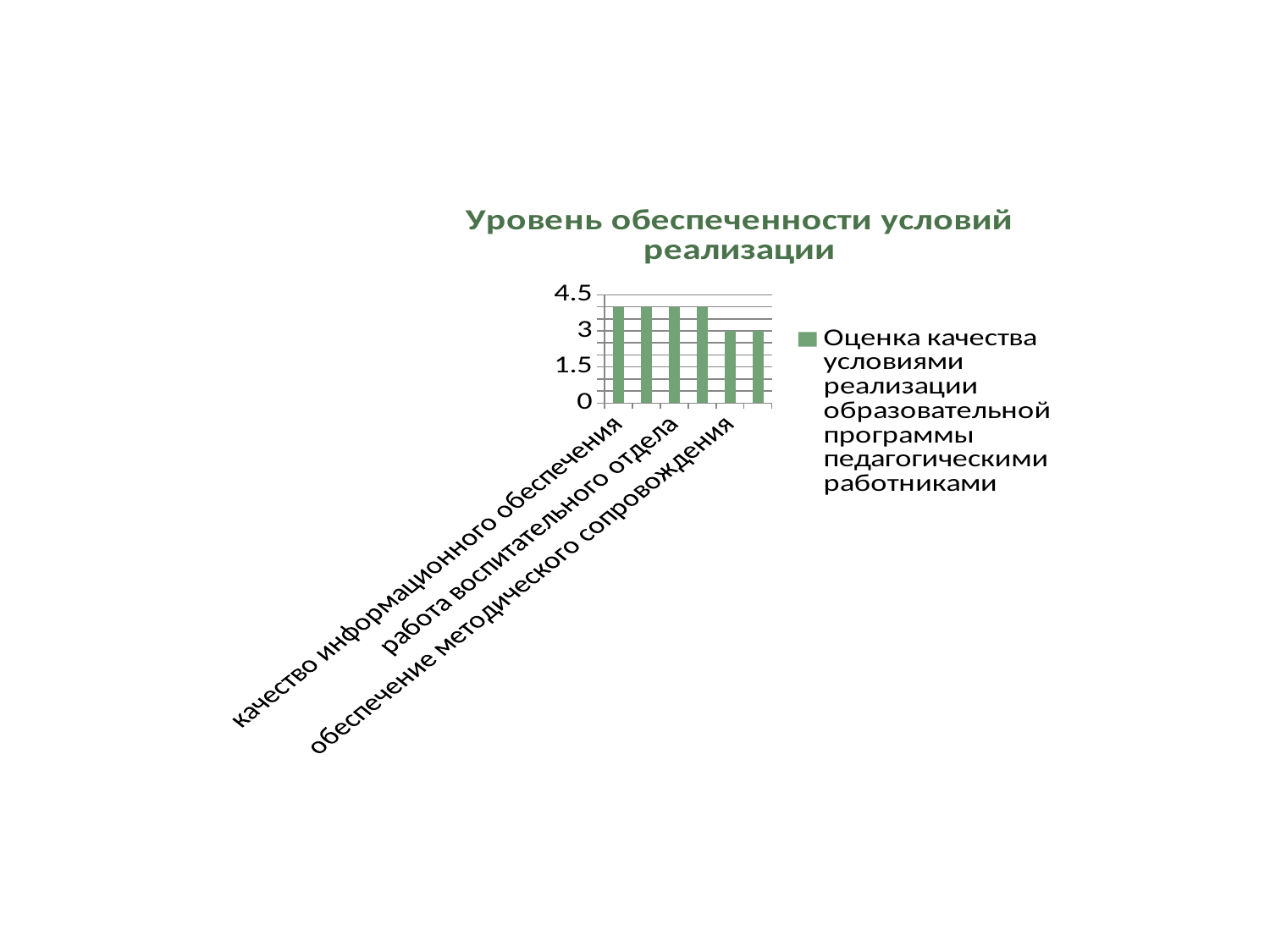
Do the bar values rise or fall from left to right along the x axis? fall What is the highest value shown on the vertical axis? 4.5 How many series does the legend list? 1 Is the value for работа воспитательного отдела greater or less than 4.5? less What is the value for обеспечение методического сопровождения? 3 What is the name of the series shown in the legend? Оценка качества условиями реализации образовательной программы педагогическими работниками Of the three labelled categories, which has the lowest value? обеспечение методического сопровождения Is the value for качество информационного обеспечения greater or less than 3? greater What kind of chart is shown on the slide? bar chart What is the title of the chart? Уровень обеспеченности условий реализации Which is larger: the value for качество информационного обеспечения or the value for обеспечение методического сопровождения? качество информационного обеспечения How many bars are plotted in the chart? 6